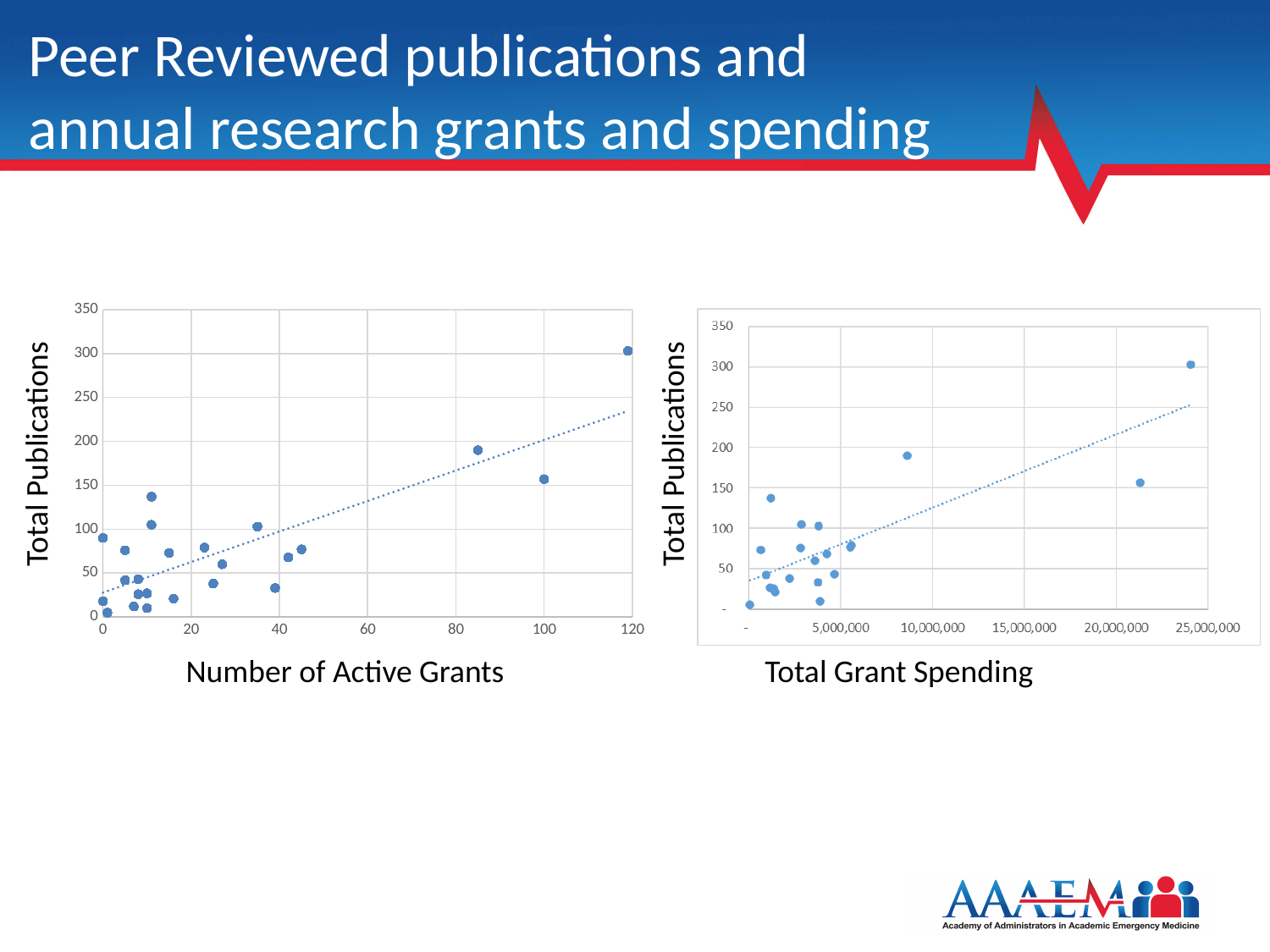
What kind of chart is the left chart (Number of Active Grants)? scatter chart In the right chart (Total Grant Spending), is the total publications value for the point with the second-highest grant spending greater or less than 200? less In the left chart (Number of Active Grants), does the point with the most active grants also have the most total publications? yes In the right chart (Total Grant Spending), do total publications generally rise or fall as total grant spending increases? rise In the right chart (Total Grant Spending), is the total publications value of the highest point greater or less than 250? greater What is the x-axis label of the left chart? Number of Active Grants In the left chart (Number of Active Grants), do total publications generally rise or fall as the number of active grants increases? rise In the right chart (Total Grant Spending), does the point with the highest grant spending also have the most total publications? yes What kind of chart is the right chart (Total Grant Spending)? scatter chart What is the x-axis label of the right chart? Total Grant Spending In the left chart (Number of Active Grants), is the total publications value for the point at 100 active grants greater or less than 200? less